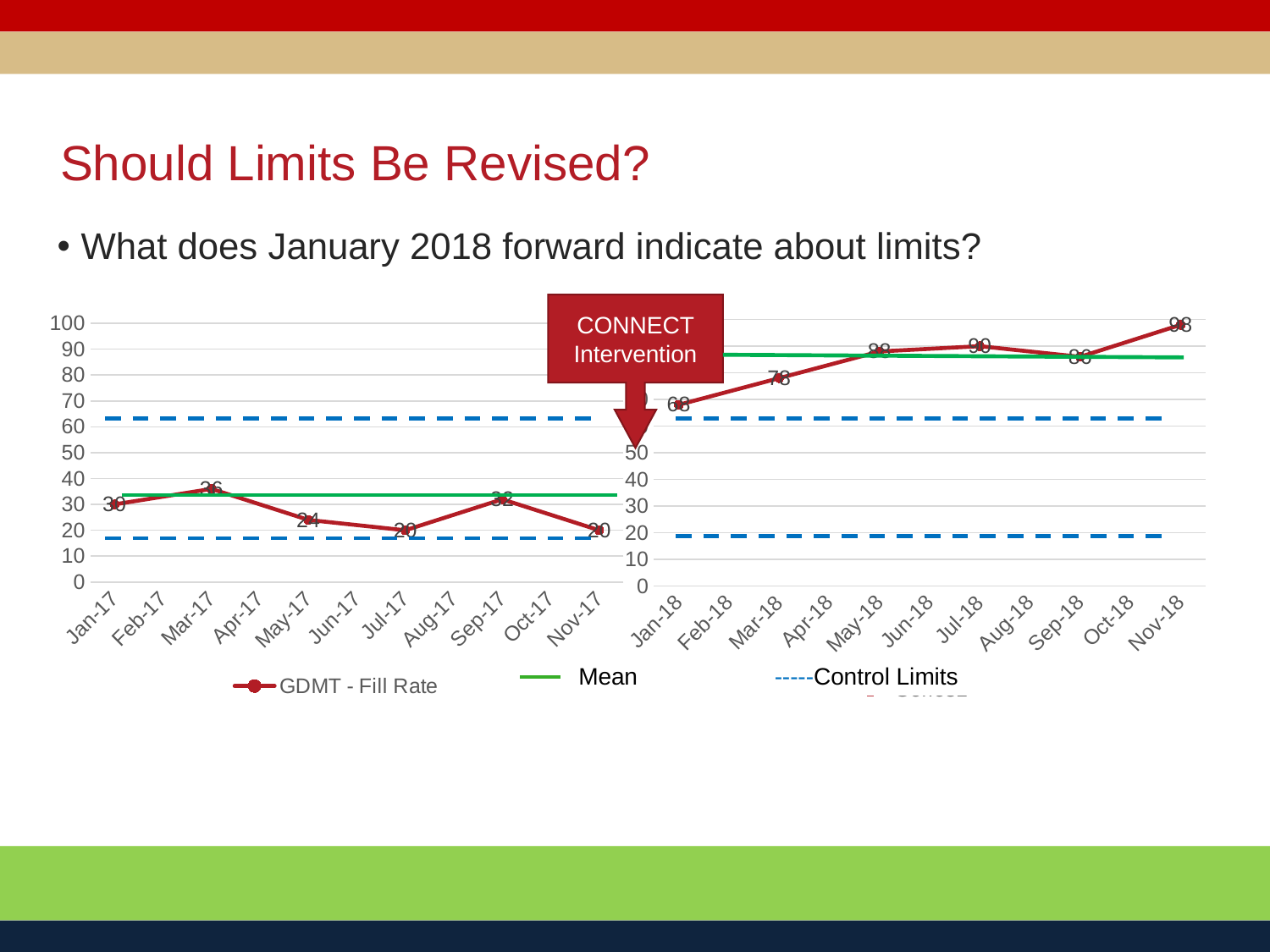
In the right chart (2018), is the GDMT - Fill Rate value for Jan-18 greater or less than 60? greater How many months are listed on the x axis of the right chart (2018)? 11 In the right chart (2018), what is the GDMT - Fill Rate value for Mar-18? 78 In the left chart (2017), which month has the highest GDMT - Fill Rate value? Mar-17 In the left chart (2017), what is the GDMT - Fill Rate value for Jan-17? 30 In the left chart (2017), what is the GDMT - Fill Rate value for Mar-17? 36 In the right chart (2018), what is the GDMT - Fill Rate value for Nov-18? 98 What type of chart is shown on the left side of the slide (2017 data)? line chart In the left chart (2017), what is the difference between the Mar-17 and Jan-17 GDMT - Fill Rate values? 6 How many entries does the legend below the charts list? 3 In the right chart (2018), does the GDMT - Fill Rate generally rise or fall from Jan-18 to Nov-18? rise In the right chart (2018), which month has the highest GDMT - Fill Rate value? Nov-18